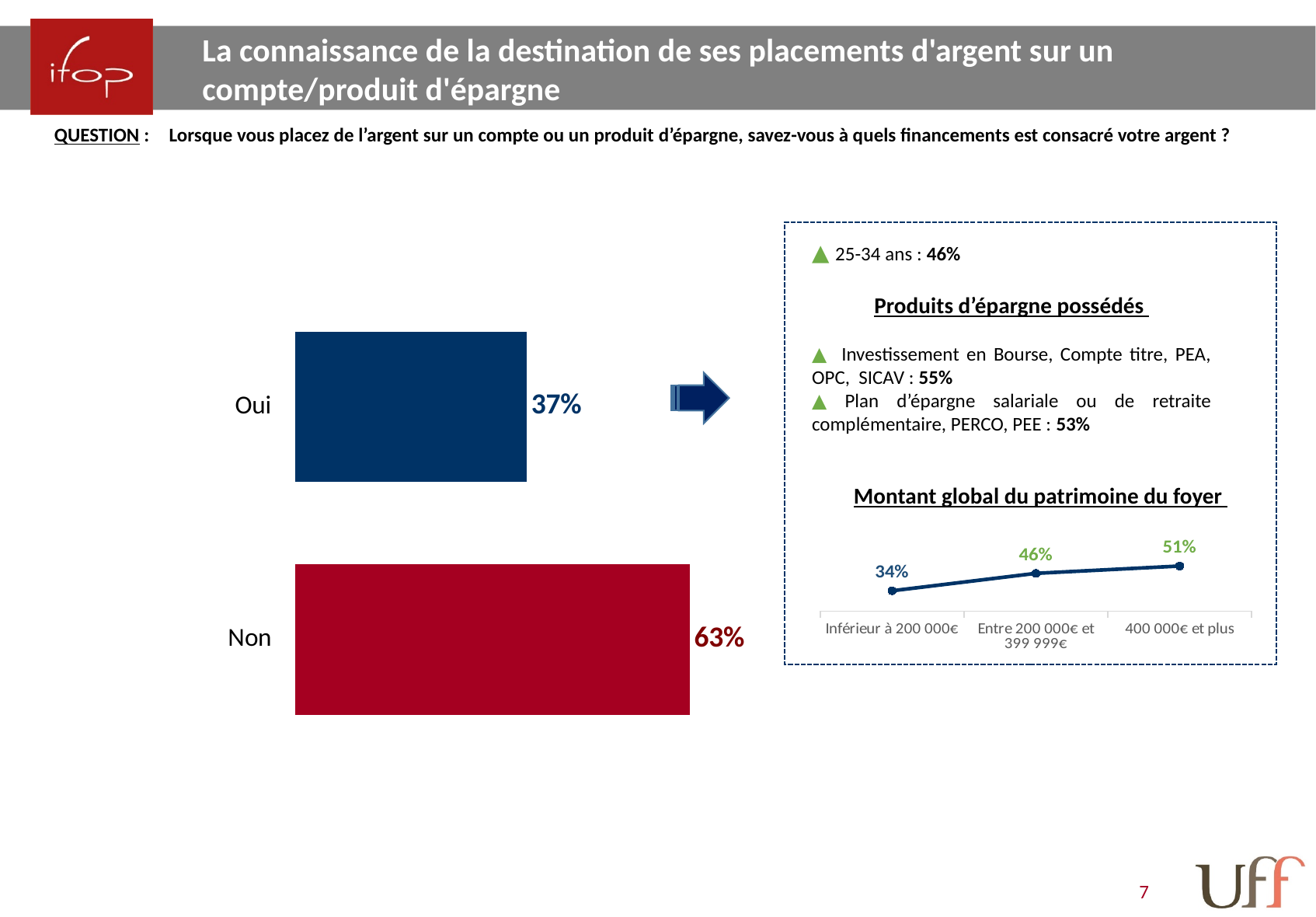
In the line chart "Montant global du patrimoine du foyer", do the values rise or fall from left to right? Rise What kind of chart is the chart on the left showing "Oui" and "Non"? Bar chart In the line chart "Montant global du patrimoine du foyer", what is the difference between the values for "400 000€ et plus" and "Entre 200 000€ et 399 999€"? 5% In the bar chart on the left, what is the value for "Non"? 63% In the line chart "Montant global du patrimoine du foyer", which category has the lowest value? Inférieur à 200 000€ In the line chart "Montant global du patrimoine du foyer", what is the value for "400 000€ et plus"? 51% In the line chart "Montant global du patrimoine du foyer", what is the value for "Inférieur à 200 000€"? 34% In the line chart "Montant global du patrimoine du foyer", how many data points are plotted? 3 In the bar chart on the left, what is the value for "Oui"? 37% In the bar chart on the left, which category has the highest value? Non In the bar chart on the left, how many categories are shown? 2 In the bar chart on the left, what is the difference between the values for "Non" and "Oui"? 26%